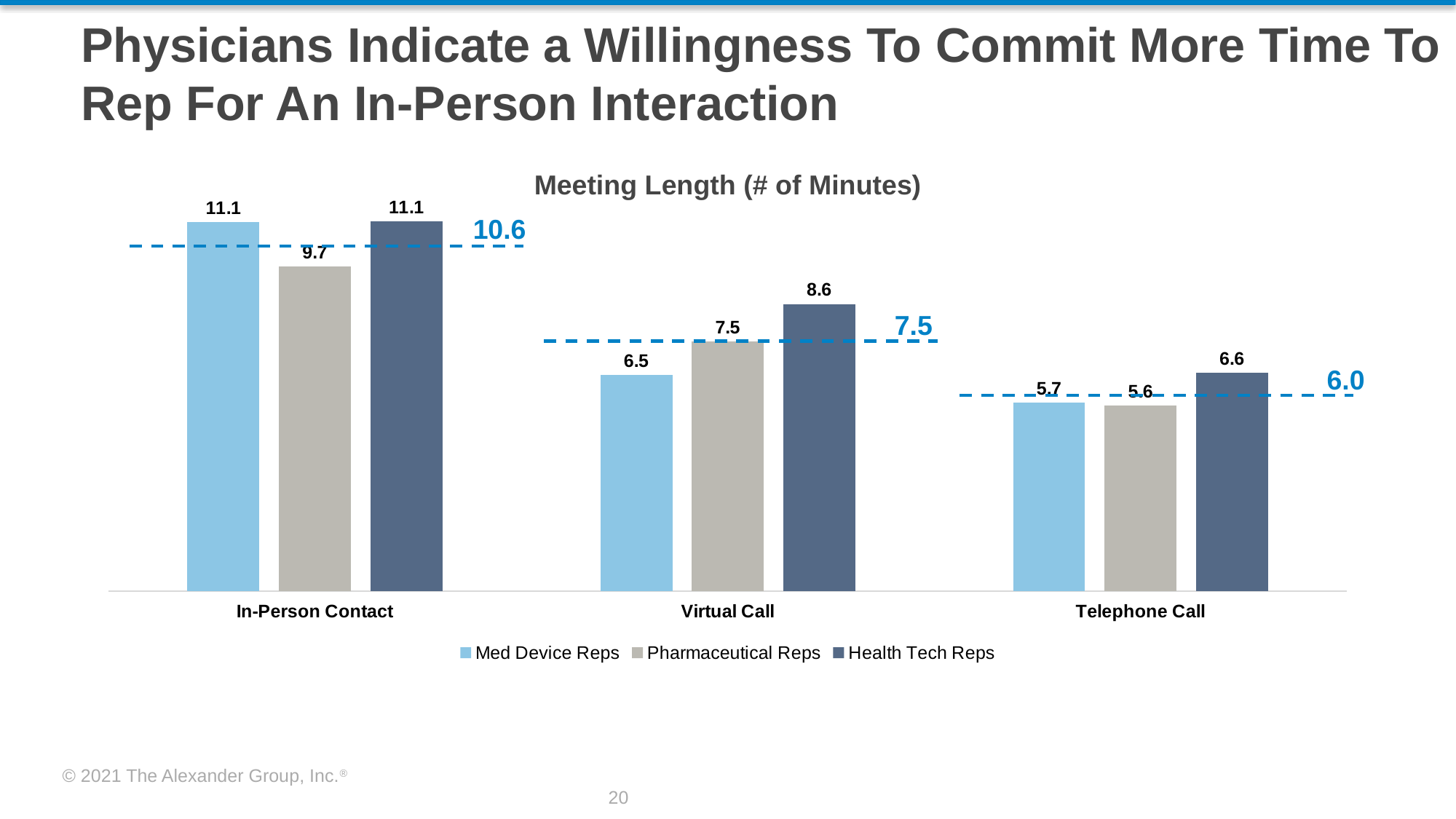
Which series has the highest meeting length for Virtual Call? Health Tech Reps What is the meeting length for Health Tech Reps for Telephone Call? 6.6 Which is larger: the Med Device Reps meeting length for Virtual Call or for Telephone Call? Virtual Call What is the meeting length for Med Device Reps for In-Person Contact? 11.1 What is the meeting length for Pharmaceutical Reps for Virtual Call? 7.5 Which series has the lowest meeting length for In-Person Contact? Pharmaceutical Reps What kind of chart is shown on the slide? Bar chart What is the chart's title? Meeting Length (# of Minutes) How many categories are shown on the x axis? 3 How many series does the legend list? 3 What is the meeting length for Pharmaceutical Reps for In-Person Contact? 9.7 What is the difference between the Health Tech Reps and Med Device Reps meeting lengths for Virtual Call? 2.1